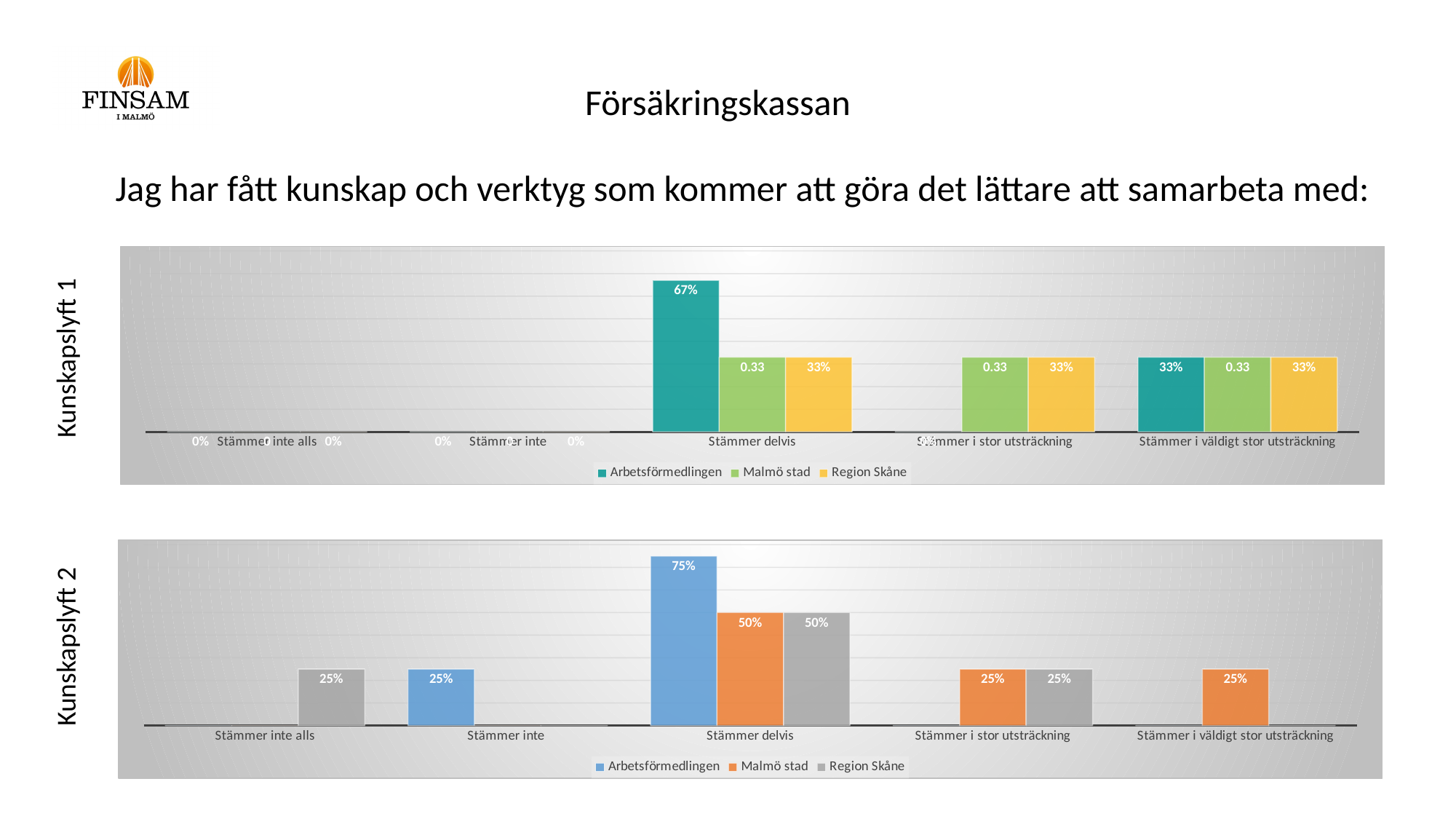
In the Kunskapslyft 1 chart, what is the difference between Arbetsförmedlingen and Region Skåne at Stämmer delvis? 34% In the Kunskapslyft 2 chart, what is the value for Arbetsförmedlingen at Stämmer delvis? 75% What kind of chart is the Kunskapslyft 1 chart? Bar chart In the Kunskapslyft 2 chart, what is the value for Region Skåne at Stämmer inte alls? 25% In the Kunskapslyft 2 chart, what is the difference between Arbetsförmedlingen and Malmö stad at Stämmer delvis? 25% How many series does the legend of the Kunskapslyft 2 chart list? 3 In the Kunskapslyft 1 chart, what is the value for Arbetsförmedlingen at Stämmer delvis? 67% In the Kunskapslyft 2 chart, what is the value for Malmö stad at Stämmer i väldigt stor utsträckning? 25% In the Kunskapslyft 1 chart, what is the value for Region Skåne at Stämmer i stor utsträckning? 33% In the Kunskapslyft 2 chart, which is larger at Stämmer delvis: Arbetsförmedlingen or Malmö stad? Arbetsförmedlingen In the Kunskapslyft 1 chart, which series has the highest value at Stämmer delvis? Arbetsförmedlingen In the Kunskapslyft 1 chart, what is the value label shown for Malmö stad at Stämmer i väldigt stor utsträckning? 0.33